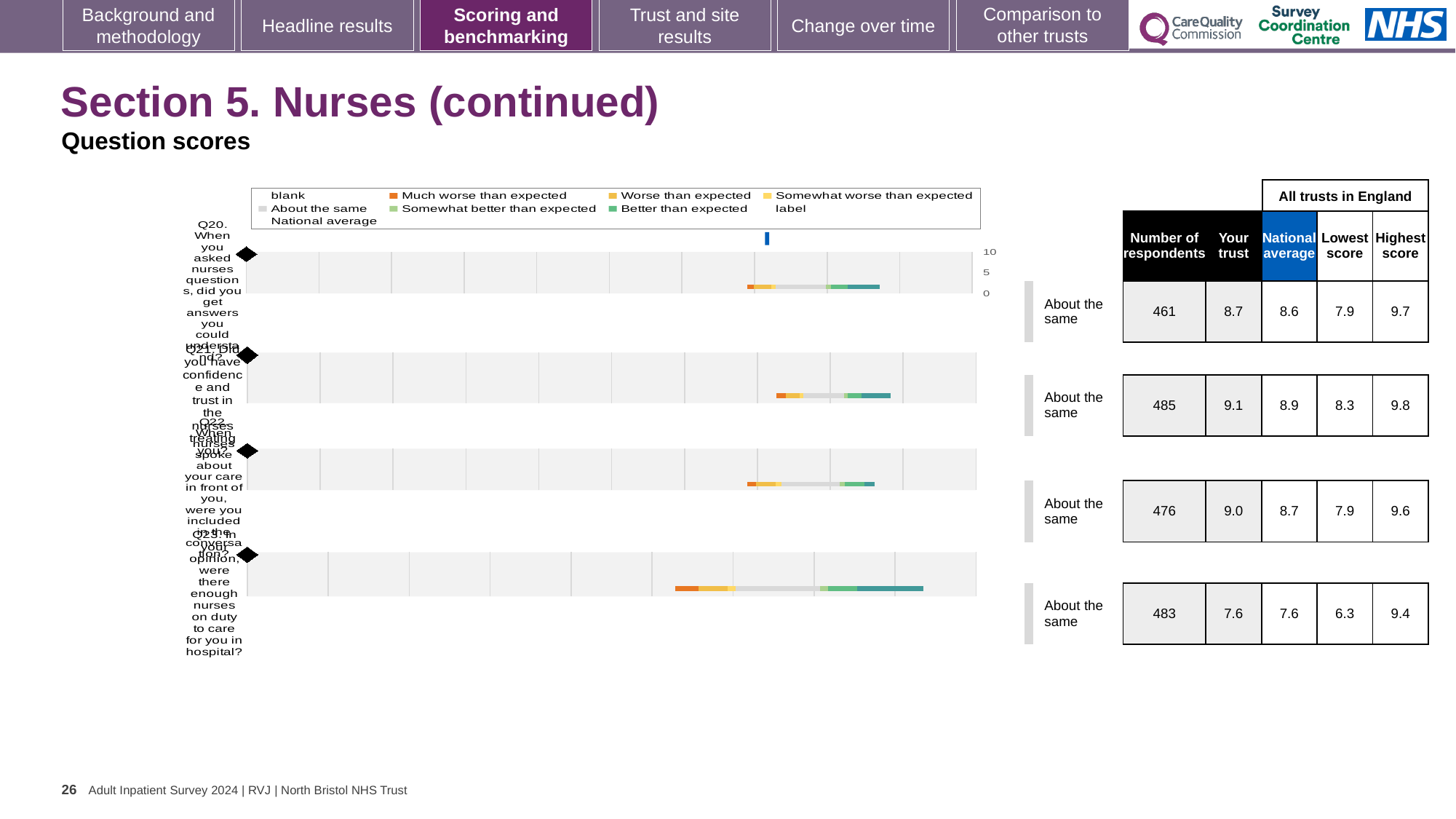
What is the 'Your trust' score for Q21 (confidence and trust in the nurses)? 9.1 What benchmark category is shown for Q20? About the same What is the national average score for Q23 (enough nurses on duty)? 7.6 How many respondents answered Q22 (nurses speaking about your care in front of you)? 476 Which question has the lowest 'Your trust' score? Q23 For Q22, which is larger: the 'Your trust' score or the national average? Your trust For Q20, what is the difference between the highest score and the lowest score across all trusts in England? 1.8 What kind of chart is used to show the question scores on this slide? Bar chart Which question has the highest 'Your trust' score? Q21 How many questions (rows) are plotted in the chart? 4 For Q21, how much higher is the 'Your trust' score than the national average? 0.2 What is the lowest score across all trusts in England for Q23? 6.3